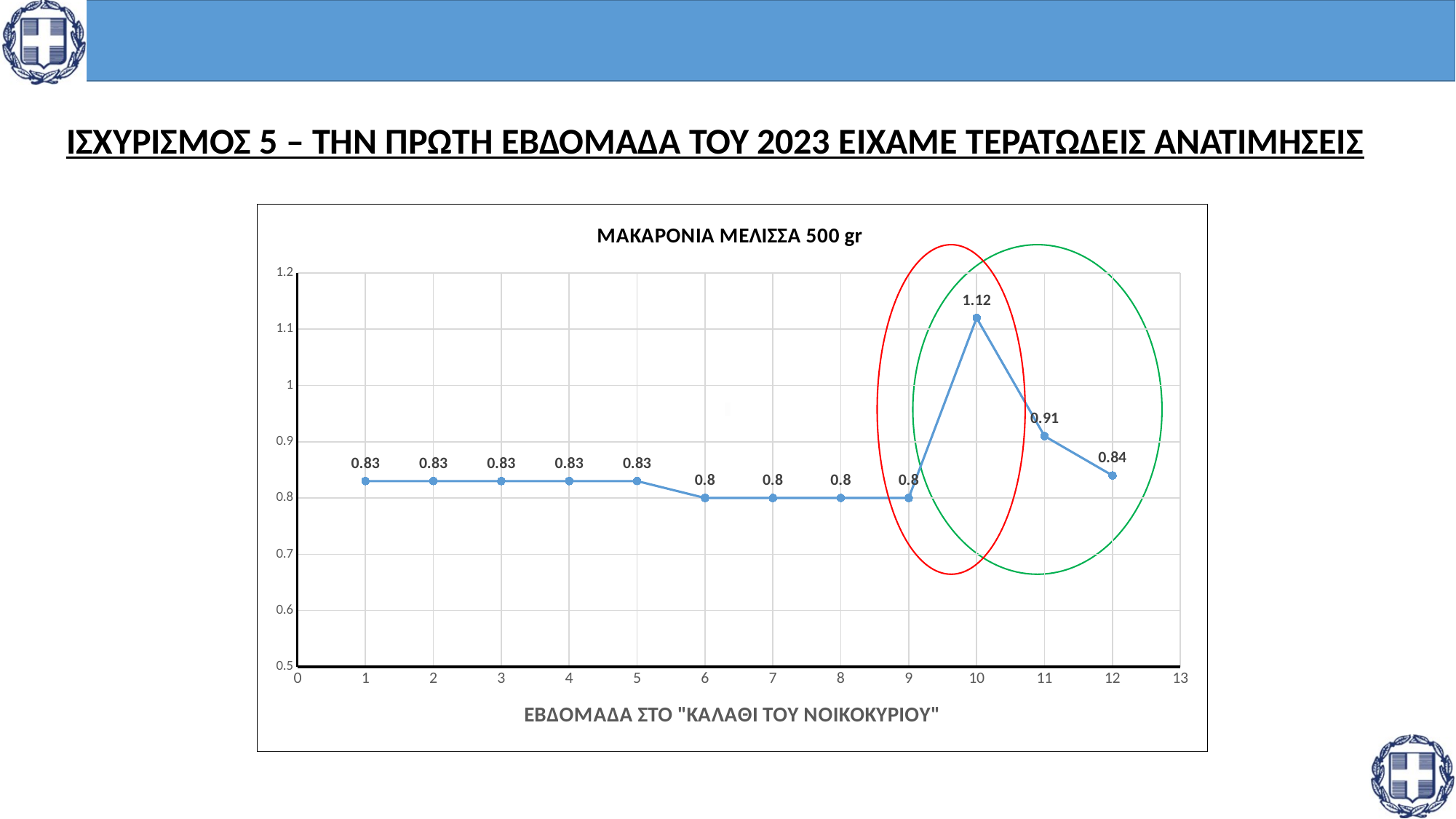
What is the value at week 12? 0.84 What is the value at week 1? 0.83 Which week has the highest value? 10 What is the title of the chart? ΜΑΚΑΡΟΝΙΑ ΜΕΛΙΣΣΑ 500 gr Which is larger, the value at week 11 or the value at week 12? week 11 How many data points are plotted on the chart? 12 What is the value at week 6? 0.8 What is the difference between the value at week 10 and the value at week 9? 0.32 What type of chart is shown on the slide? line chart What is the x-axis title of the chart? ΕΒΔΟΜΑΔΑ ΣΤΟ "ΚΑΛΑΘΙ ΤΟΥ ΝΟΙΚΟΚΥΡΙΟΥ" What is the value at week 11? 0.91 What is the value at week 10? 1.12